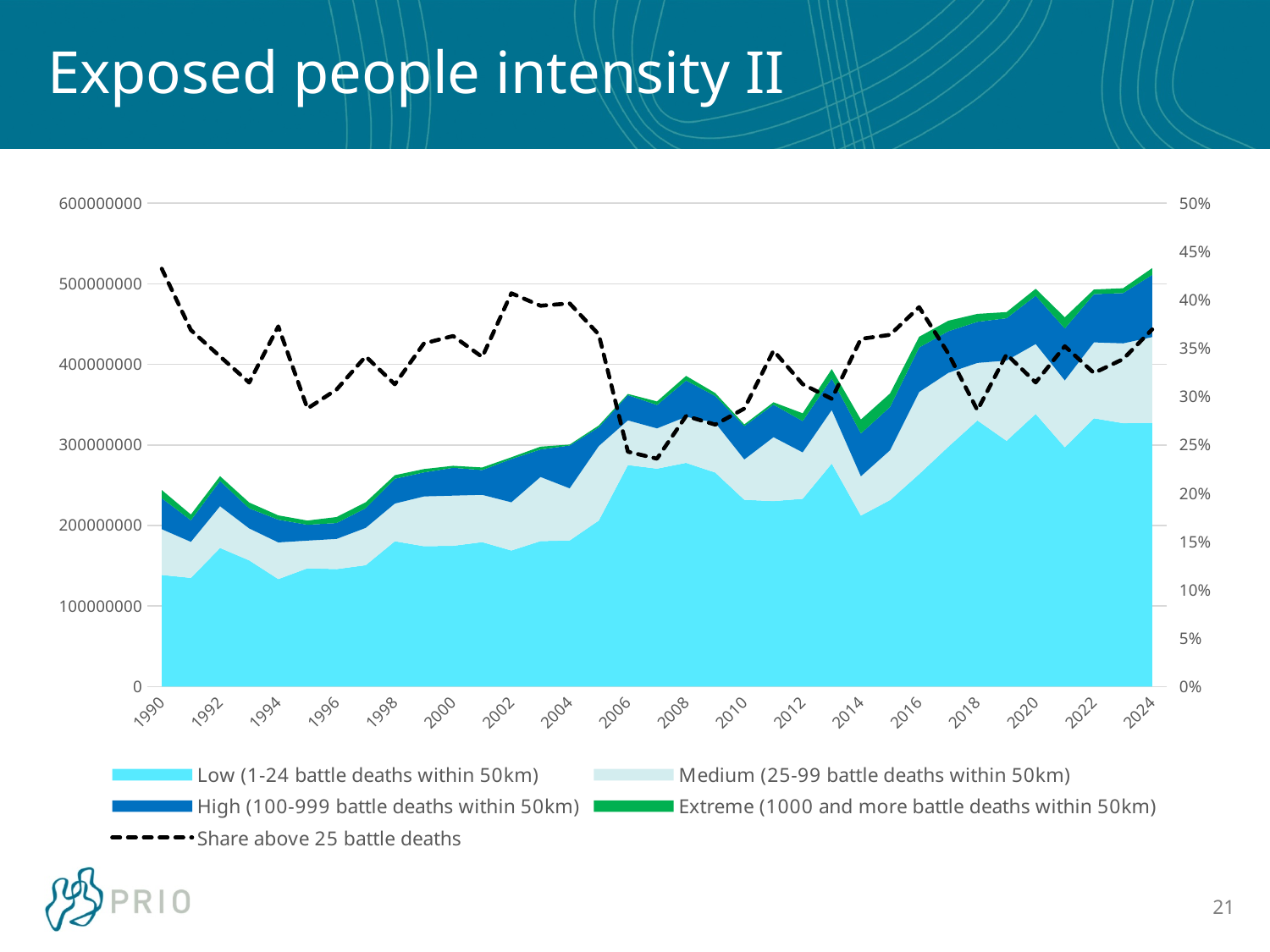
Which year has the highest total stacked value? 2024 What kind of chart is shown on the slide? stacked area chart with a dashed line Is the value of the Low (1-24 battle deaths within 50km) series in 2024 greater or less than 300000000? greater Is the total stacked value in 2024 greater or less than 500000000? greater How many year labels are shown on the x axis? 18 Does the total number of exposed people rise or fall from 1990 to 2024? rise How many series does the legend list? 5 Is the total stacked value in 1990 greater or less than 300000000? less Which series is drawn as a dashed black line? Share above 25 battle deaths What is the title of the slide containing the chart? Exposed people intensity II